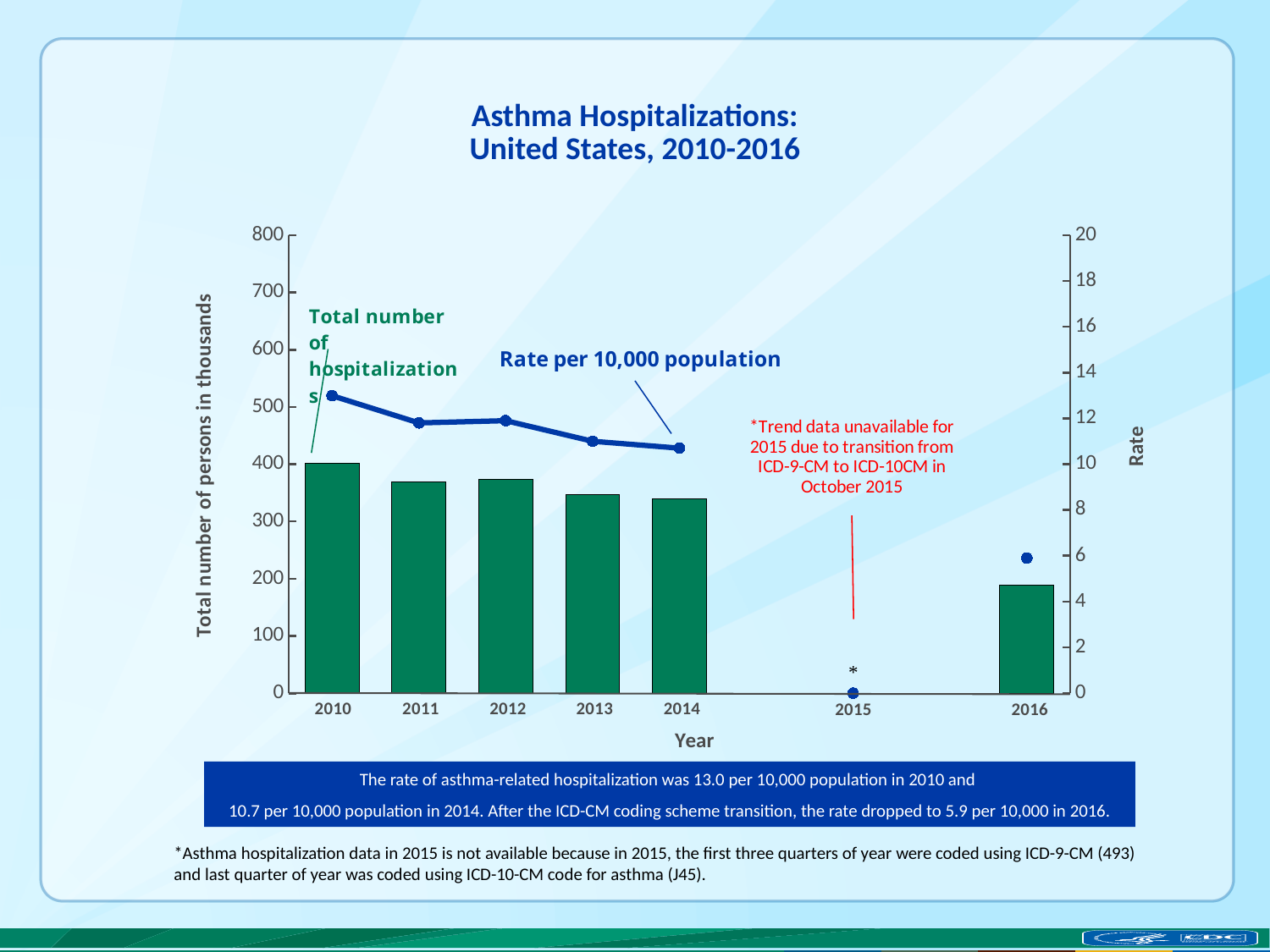
What was the rate of asthma hospitalization per 10,000 population in 2014? 10.7 Among the years with data, which year has the shortest bar for total number of hospitalizations? 2016 Which year had more total hospitalizations, 2010 or 2014? 2010 Is the total number of hospitalizations (in thousands) for 2010 greater or less than 300? greater By how much did the rate per 10,000 population fall from 2010 to 2014? 2.3 For which year on the x axis is trend data unavailable? 2015 What was the rate of asthma hospitalization per 10,000 population in 2016? 5.9 Is the total number of hospitalizations (in thousands) for 2016 greater or less than 300? less By how much did the rate per 10,000 population fall from 2014 to 2016? 4.8 What was the rate of asthma hospitalization per 10,000 population in 2010? 13.0 Does the rate per 10,000 population rise or fall from 2010 to 2014? fall Which year has the tallest bar for total number of hospitalizations? 2010